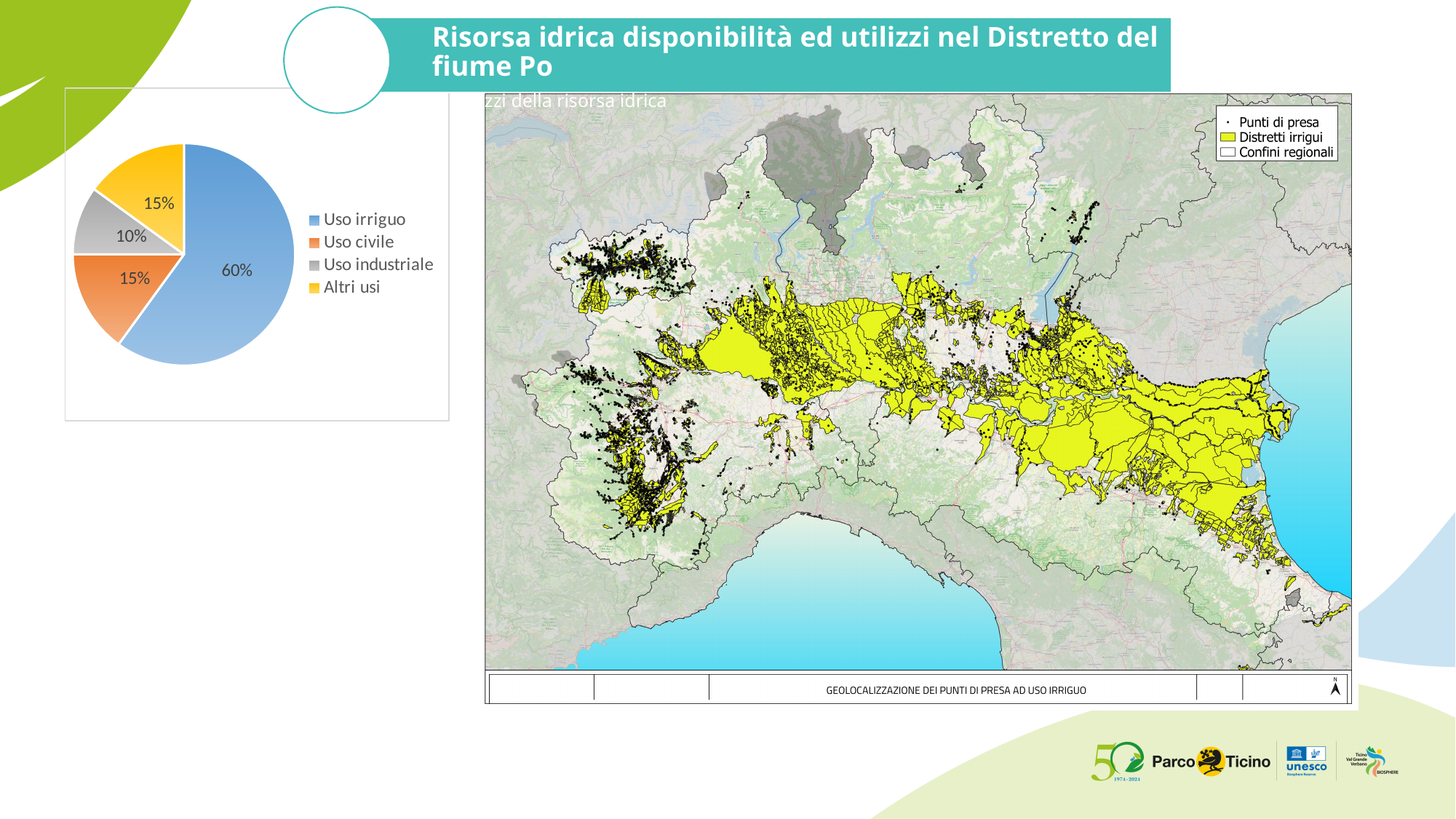
In the pie chart, what share is labelled for Uso civile? 15% In the pie chart, what share is labelled for Altri usi? 15% In the pie chart, what colour is the slice for Uso irriguo? blue In the pie chart, which is larger: Uso civile or Uso industriale? Uso civile In the pie chart, what is the difference between the shares of Uso irriguo and Uso civile? 45% Which category has the largest slice in the pie chart? Uso irriguo In the pie chart, what colour is the slice for Altri usi? yellow Which category has the smallest slice in the pie chart? Uso industriale How many categories does the pie chart legend list? 4 In the pie chart, what share is labelled for Uso irriguo? 60% What kind of chart is shown on the left of the slide? pie chart In the pie chart, what share is labelled for Uso industriale? 10%